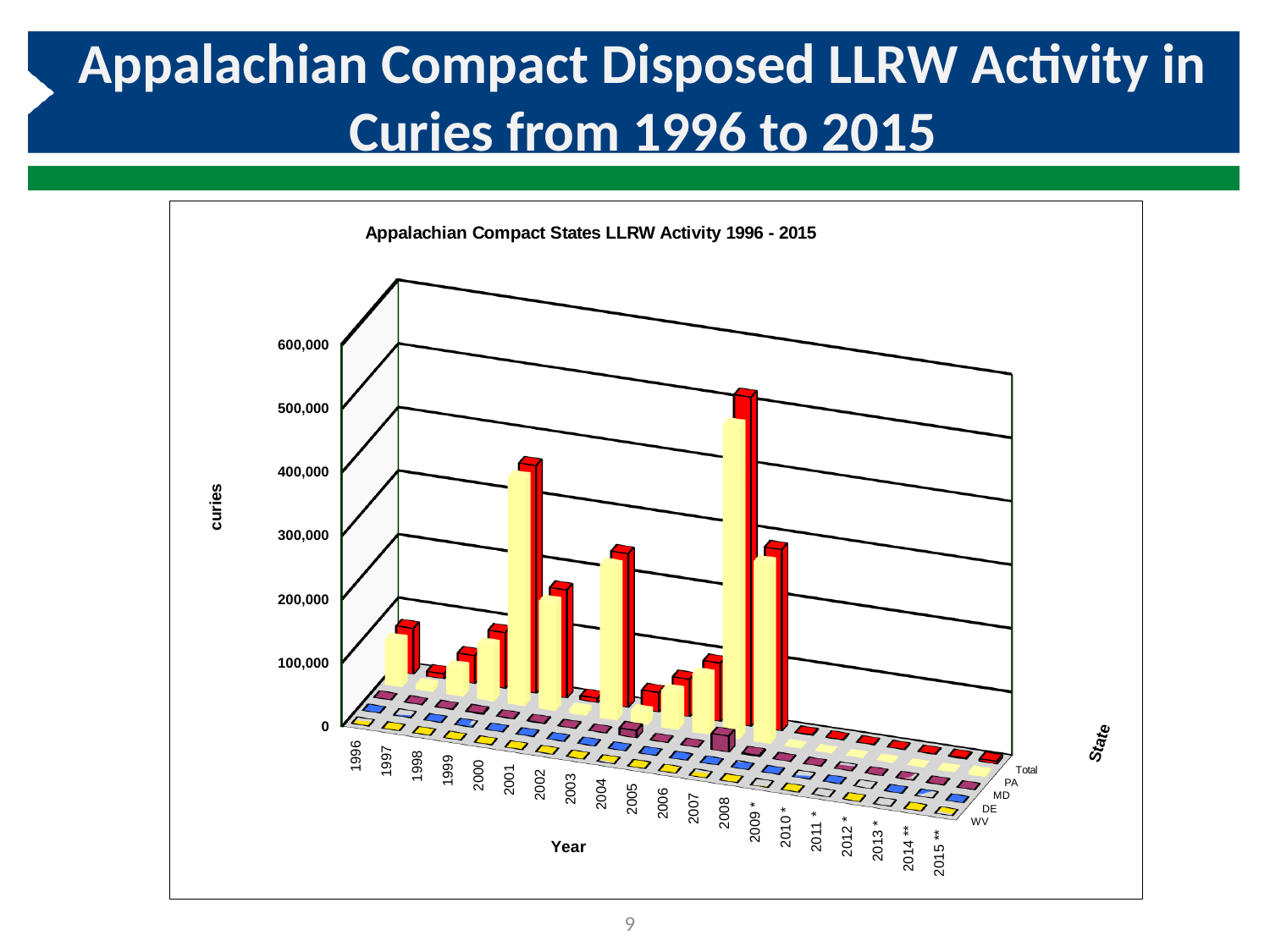
Is the Total value for 2004 greater or less than 200,000? less Is the Total value for 2009 greater or less than 200,000? less What is the title printed inside the chart? Appalachian Compact States LLRW Activity 1996 - 2015 Is the Total value for 2012 greater or less than 100,000? less Which year has the larger Total bar, 2001 or 2004? 2001 What is the label on the vertical axis of the chart? curies How many years are shown along the Year axis of the chart? 20 Which year has the highest Total bar in the chart? 2007 What kind of chart is shown on the slide? bar chart How many state series are listed along the State axis of the chart? 5